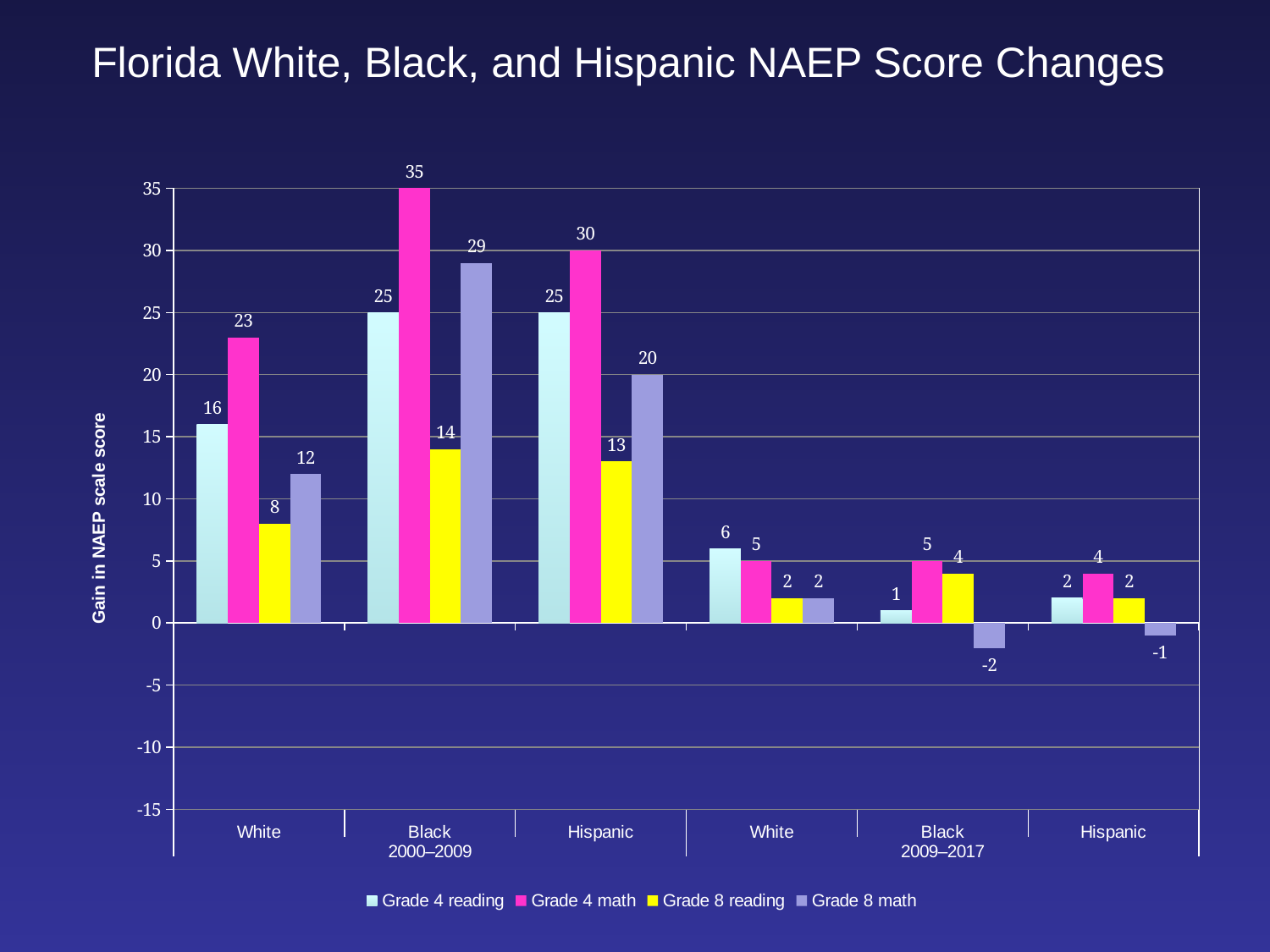
What is the title of the chart? Florida White, Black, and Hispanic NAEP Score Changes Which group and period has the highest Grade 4 math gain? Black, 2000–2009 How many category groups are shown on the x axis? 6 What is the Grade 8 math gain for Black students in 2009–2017? -2 What is the difference between the Grade 8 math gain for Black students in 2000–2009 and for Hispanic students in 2000–2009? 9 Which group and period has the lowest Grade 8 math gain? Black, 2009–2017 What is the Grade 8 reading gain for White students in 2000–2009? 8 What is the Grade 4 math gain for Black students in 2000–2009? 35 What kind of chart is this? Bar chart How many series does the legend list? 4 Which is larger: the Grade 4 reading gain for White students in 2000–2009 or the Grade 4 reading gain for Hispanic students in 2000–2009? Hispanic, 2000–2009 What is the y-axis label? Gain in NAEP scale score